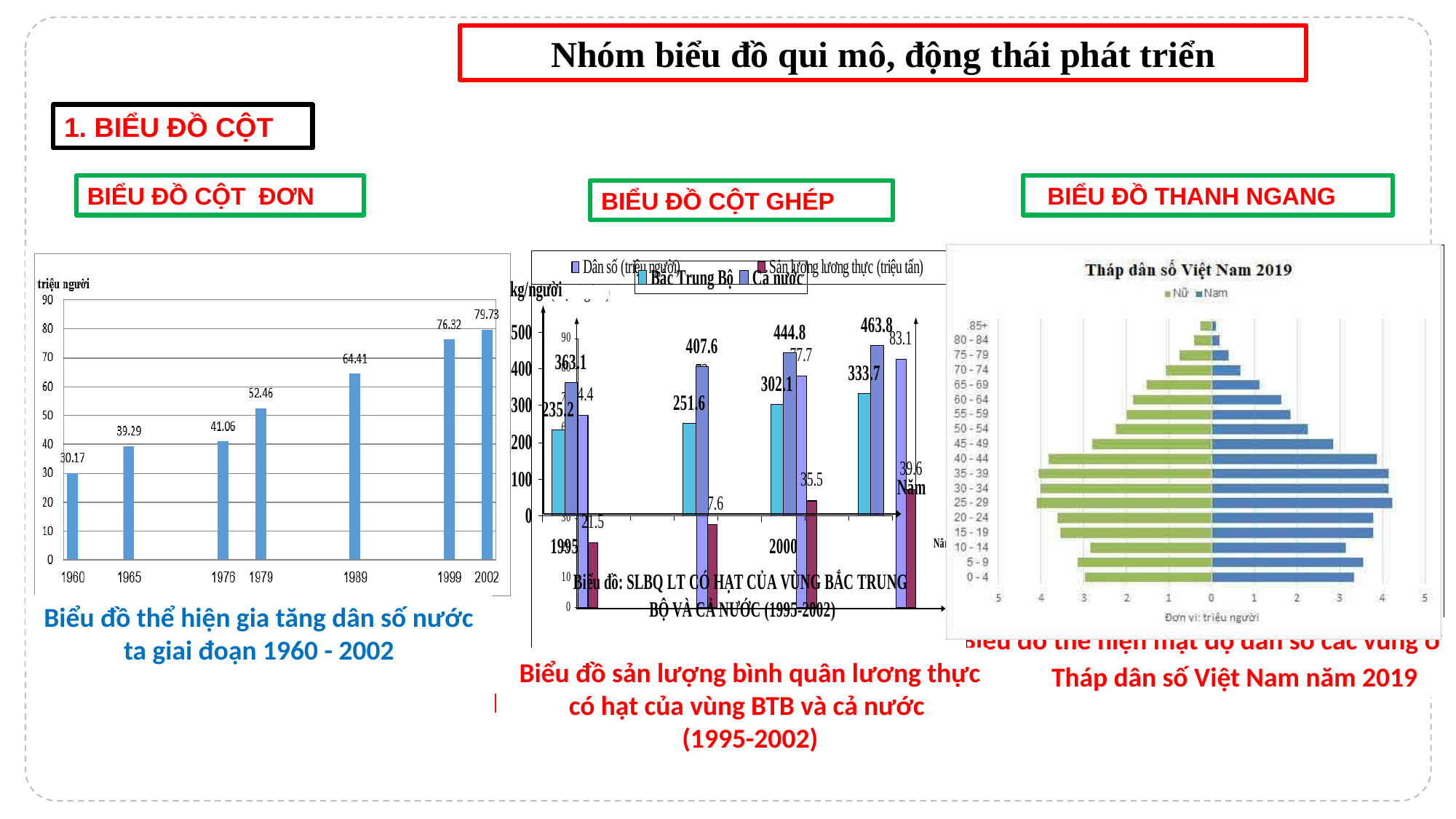
In the left chart (Biểu đồ thể hiện gia tăng dân số nước ta giai đoạn 1960 - 2002), how many bars are plotted? 7 In the left chart (Biểu đồ thể hiện gia tăng dân số nước ta giai đoạn 1960 - 2002), which year has the highest value? 2002 In the left chart (Biểu đồ thể hiện gia tăng dân số nước ta giai đoạn 1960 - 2002), do the values rise or fall from 1960 to 2002? rise In the right chart (Tháp dân số Việt Nam 2019), how many age groups are shown? 18 In the left chart (Biểu đồ thể hiện gia tăng dân số nước ta giai đoạn 1960 - 2002), what is the value for 1989? 64.41 In the right chart (Tháp dân số Việt Nam 2019), is the value for Nữ in the 40 - 44 age group greater or less than 3? greater In the middle grouped bar chart (Biểu đồ sản lượng bình quân lương thực có hạt của vùng BTB và cả nước), what is the highest value shown for Cả nước? 463.8 In the right chart (Tháp dân số Việt Nam 2019), how many series does the legend list? 2 In the middle grouped bar chart (Biểu đồ sản lượng bình quân lương thực có hạt của vùng BTB và cả nước), what is the lowest value shown for Bắc Trung Bộ? 235.2 In the left chart (Biểu đồ thể hiện gia tăng dân số nước ta giai đoạn 1960 - 2002), what is the value for 1960? 30.17 In the left chart (Biểu đồ thể hiện gia tăng dân số nước ta giai đoạn 1960 - 2002), what unit is shown on the vertical axis? triệu người In the left chart (Biểu đồ thể hiện gia tăng dân số nước ta giai đoạn 1960 - 2002), what is the difference between the values for 2002 and 1999? 3.41